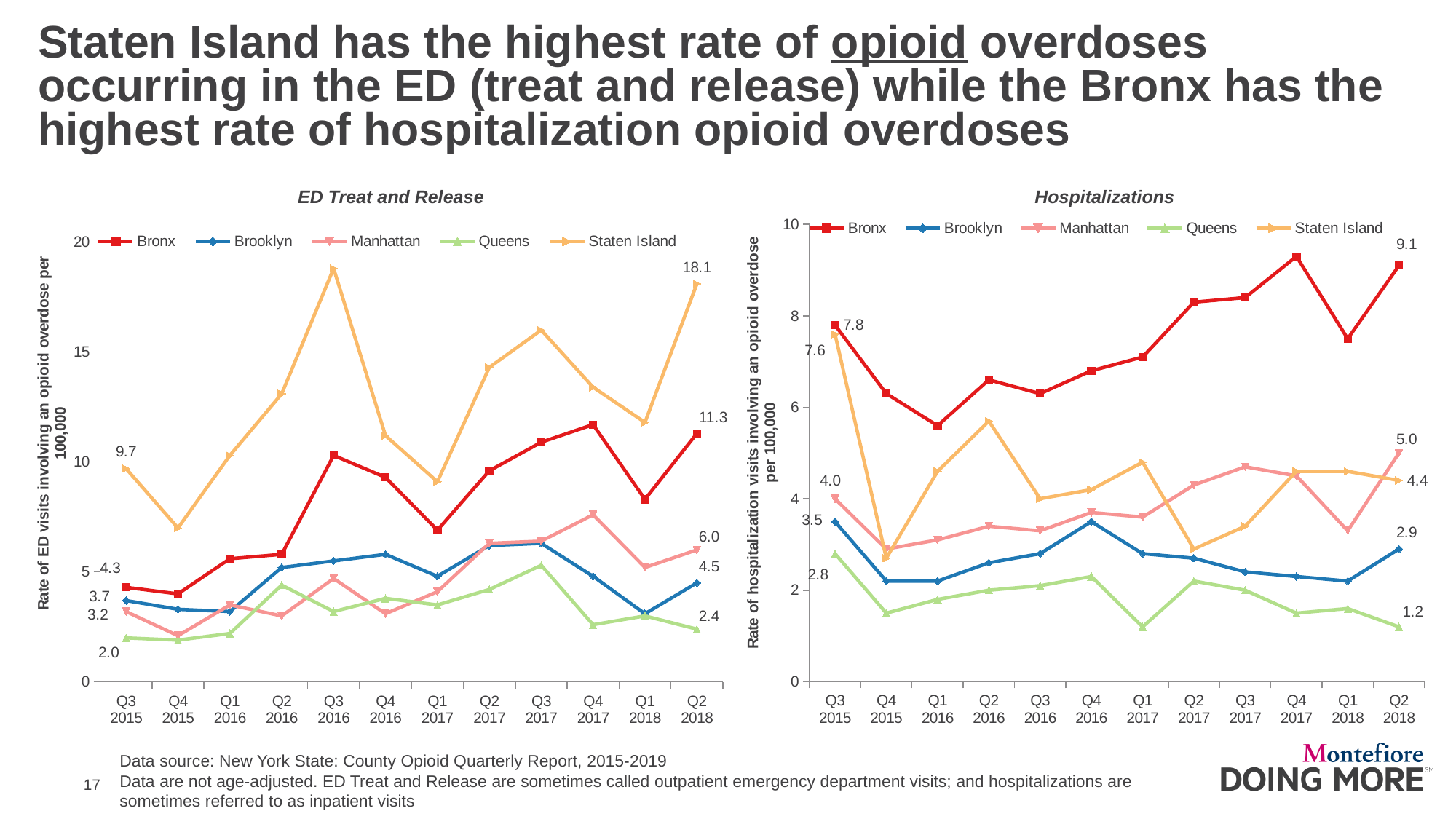
On the Hospitalizations chart, what is the value for the Bronx in Q3 2015? 7.8 How many series does the legend of the ED Treat and Release chart list? 5 What kind of chart is the Hospitalizations chart? line chart On the ED Treat and Release chart, which borough has the highest value in Q2 2018? Staten Island On the ED Treat and Release chart, what is the difference between the Staten Island and Bronx values in Q2 2018? 6.8 On the ED Treat and Release chart, what is the value for Staten Island in Q2 2018? 18.1 On the Hospitalizations chart, which is larger in Q2 2018: Manhattan or Staten Island? Manhattan On the ED Treat and Release chart, is the value for Staten Island in Q3 2016 greater or less than 15? greater On the Hospitalizations chart, which borough has the lowest value in Q2 2018? Queens On the Hospitalizations chart, by how much did the Bronx value change from Q3 2015 to Q2 2018? 1.3 How many quarters are shown on the x axis of the Hospitalizations chart? 12 On the ED Treat and Release chart, what is the value for Queens in Q3 2015? 2.0